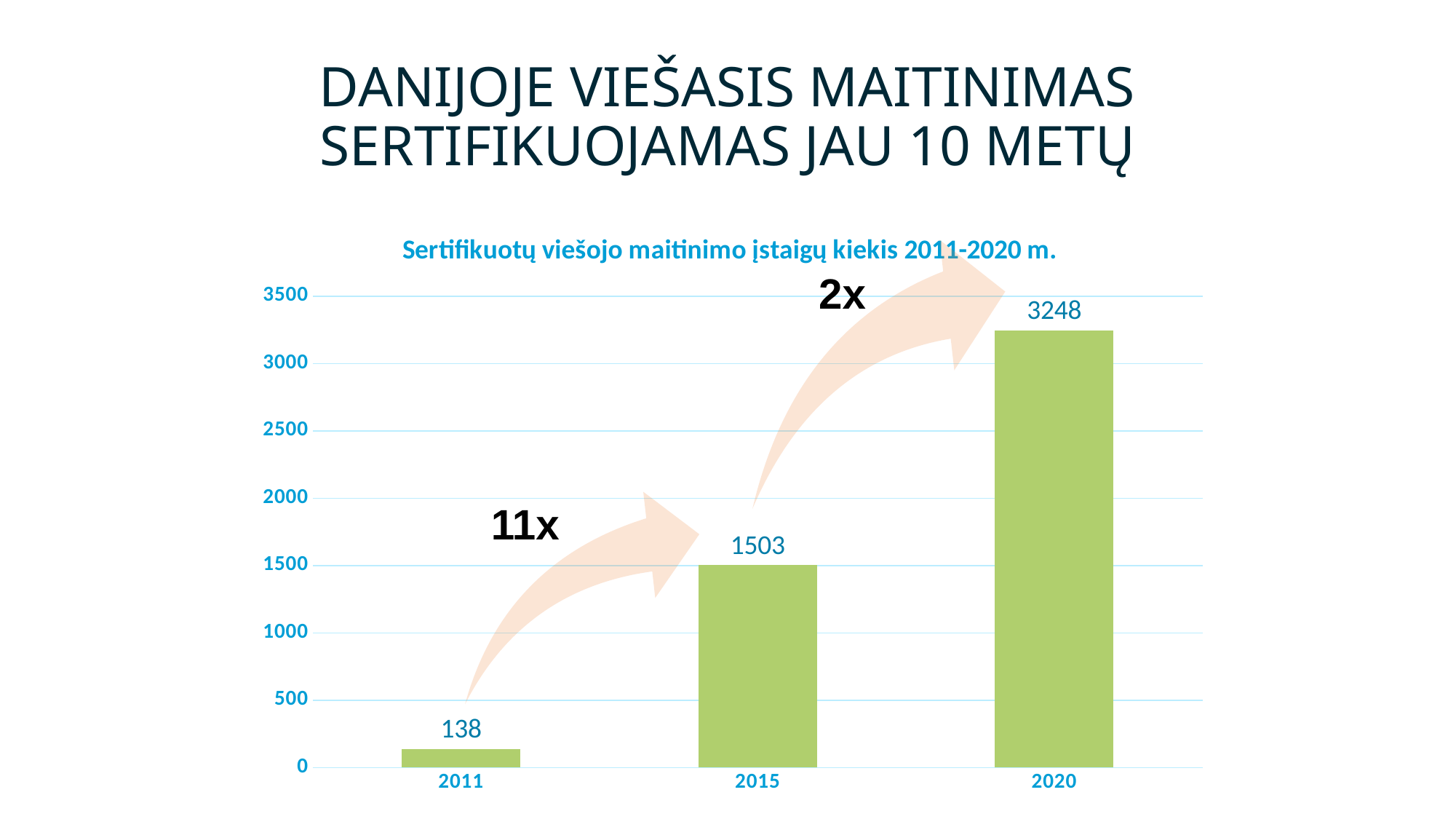
Which year has the highest value? 2020 Do the values rise or fall from 2011 to 2020? rise Which is larger, the value for 2015 or the value for 2011? 2015 How many years are shown on the x axis? 3 What kind of chart is shown? bar chart What is the value for 2015? 1503 What is the value for 2020? 3248 What is the difference between the values for 2020 and 2015? 1745 What is the difference between the values for 2015 and 2011? 1365 What is the value for 2011? 138 Is the value for 2020 greater or less than 3000? greater Which year has the lowest value? 2011